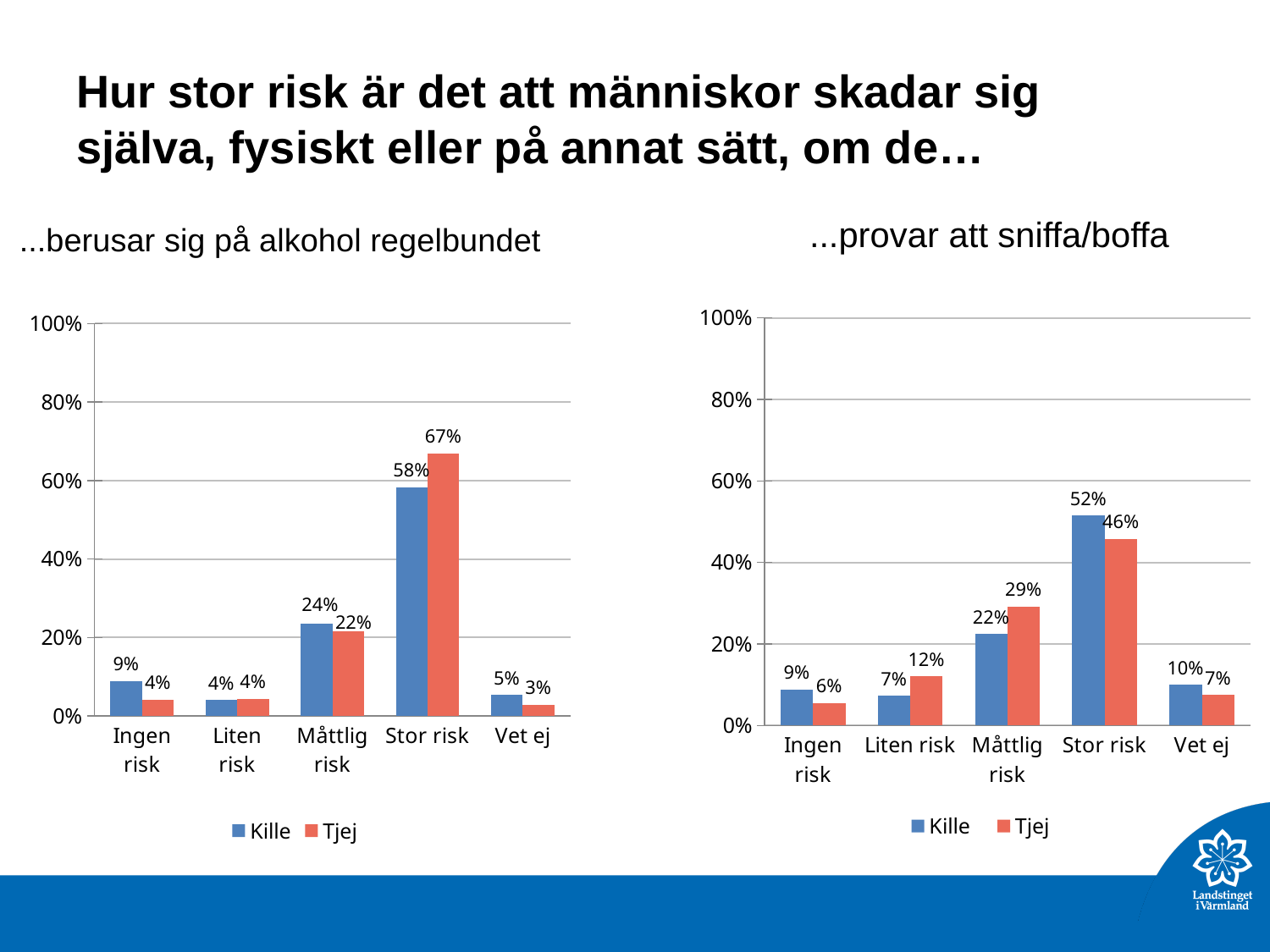
How many categories are shown on the x axis of the left chart (...berusar sig på alkohol regelbundet)? 5 How many series does the legend of the right chart (...provar att sniffa/boffa) list? 2 In the left chart (...berusar sig på alkohol regelbundet), what is the value for Kille in the Stor risk category? 58% In the right chart (...provar att sniffa/boffa), what is the value for Tjej in the Liten risk category? 12% In the right chart (...provar att sniffa/boffa), what is the value for Kille in the Vet ej category? 10% In the left chart (...berusar sig på alkohol regelbundet), which category has the highest value for Tjej? Stor risk In the right chart (...provar att sniffa/boffa), what is the difference between the Kille and Tjej values for Stor risk? 6% What kind of chart is the left chart (...berusar sig på alkohol regelbundet)? Bar chart In the right chart (...provar att sniffa/boffa), which is larger for Måttlig risk, Kille or Tjej? Tjej In the left chart (...berusar sig på alkohol regelbundet), what is the value for Tjej in the Måttlig risk category? 22% In the right chart (...provar att sniffa/boffa), which category has the lowest value for Tjej? Ingen risk In the left chart (...berusar sig på alkohol regelbundet), what is the difference between the Tjej and Kille values for Stor risk? 9%